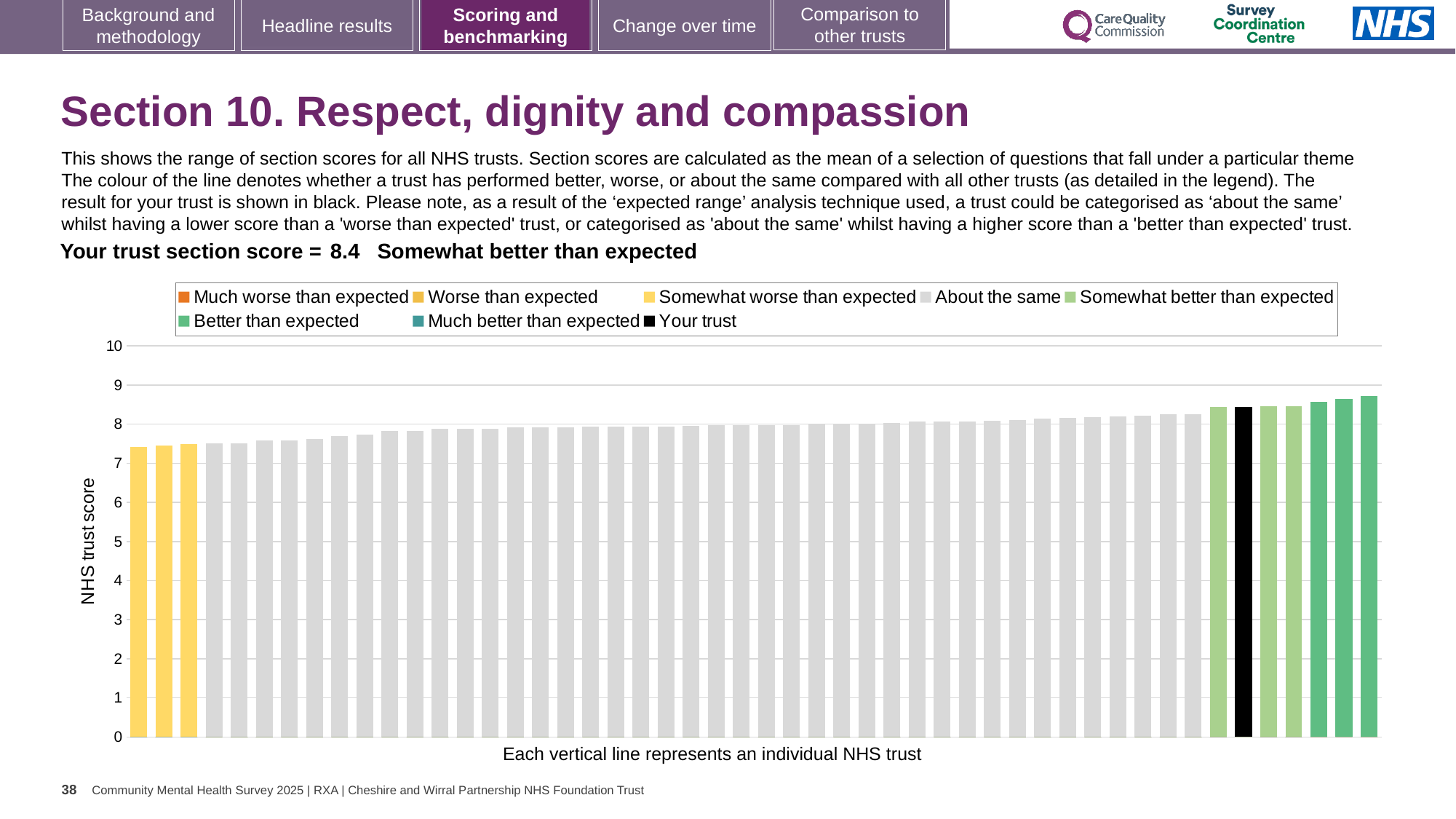
Which category is your trust placed in according to the text above the chart? Somewhat better than expected Is the value of the black 'Your trust' bar greater or less than 8? greater What is the highest tick value shown on the vertical axis? 10 What kind of chart is shown on the slide? bar chart What is the section score for your trust shown on the slide? 8.4 Do the bar values rise or fall from left to right along the x axis? rise What is the label on the vertical axis of the chart? NHS trust score Is the value of the leftmost (lowest) bar greater or less than 8? less Is the value of the leftmost (lowest) bar greater or less than 7? greater How many bars are coloured yellow (Somewhat worse than expected)? 3 How many entries does the chart legend list? 8